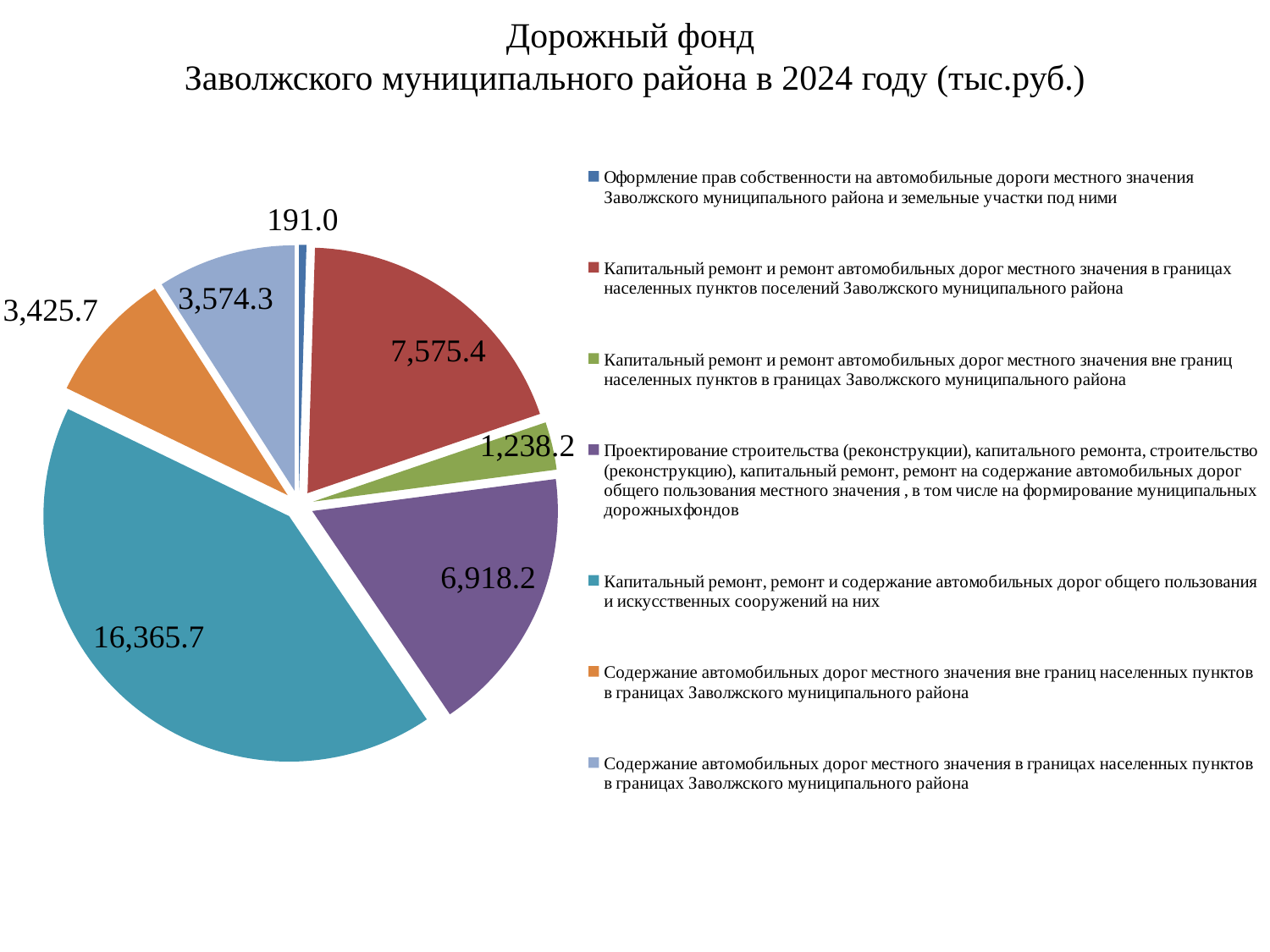
What is the value for "Оформление прав собственности на автомобильные дороги местного значения Заволжского муниципального района и земельные участки под ними"? 191.0 Which category has the smallest slice of the pie? Оформление прав собственности на автомобильные дороги местного значения Заволжского муниципального района и земельные участки под ними How many entries does the legend list? 7 How many slices does the pie chart have? 7 What kind of chart is shown on the slide? pie chart Which category has the largest slice of the pie? Капитальный ремонт, ремонт и содержание автомобильных дорог общего пользования и искусственных сооружений на них What is the difference between the value for "Капитальный ремонт, ремонт и содержание автомобильных дорог общего пользования и искусственных сооружений на них" (16,365.7) and the value for "Капитальный ремонт и ремонт автомобильных дорог местного значения в границах населенных пунктов поселений Заволжского муниципального района" (7,575.4)? 8,790.3 What is the difference between the value for "Капитальный ремонт и ремонт автомобильных дорог местного значения в границах населенных пунктов поселений" (7,575.4) and the value for "Капитальный ремонт и ремонт автомобильных дорог местного значения вне границ населенных пунктов" (1,238.2)? 6,337.2 What is the value for "Проектирование строительства (реконструкции), капитального ремонта, строительство (реконструкцию), капитальный ремонт, ремонт на содержание автомобильных дорог общего пользования местного значения"? 6,918.2 What is the title of the chart on the slide? Дорожный фонд Заволжского муниципального района в 2024 году (тыс.руб.) Which is larger: the value for "Содержание автомобильных дорог местного значения в границах населенных пунктов" or the value for "Содержание автомобильных дорог местного значения вне границ населенных пунктов"? Содержание автомобильных дорог местного значения в границах населенных пунктов (3,574.3) What is the value for "Капитальный ремонт, ремонт и содержание автомобильных дорог общего пользования и искусственных сооружений на них"? 16,365.7